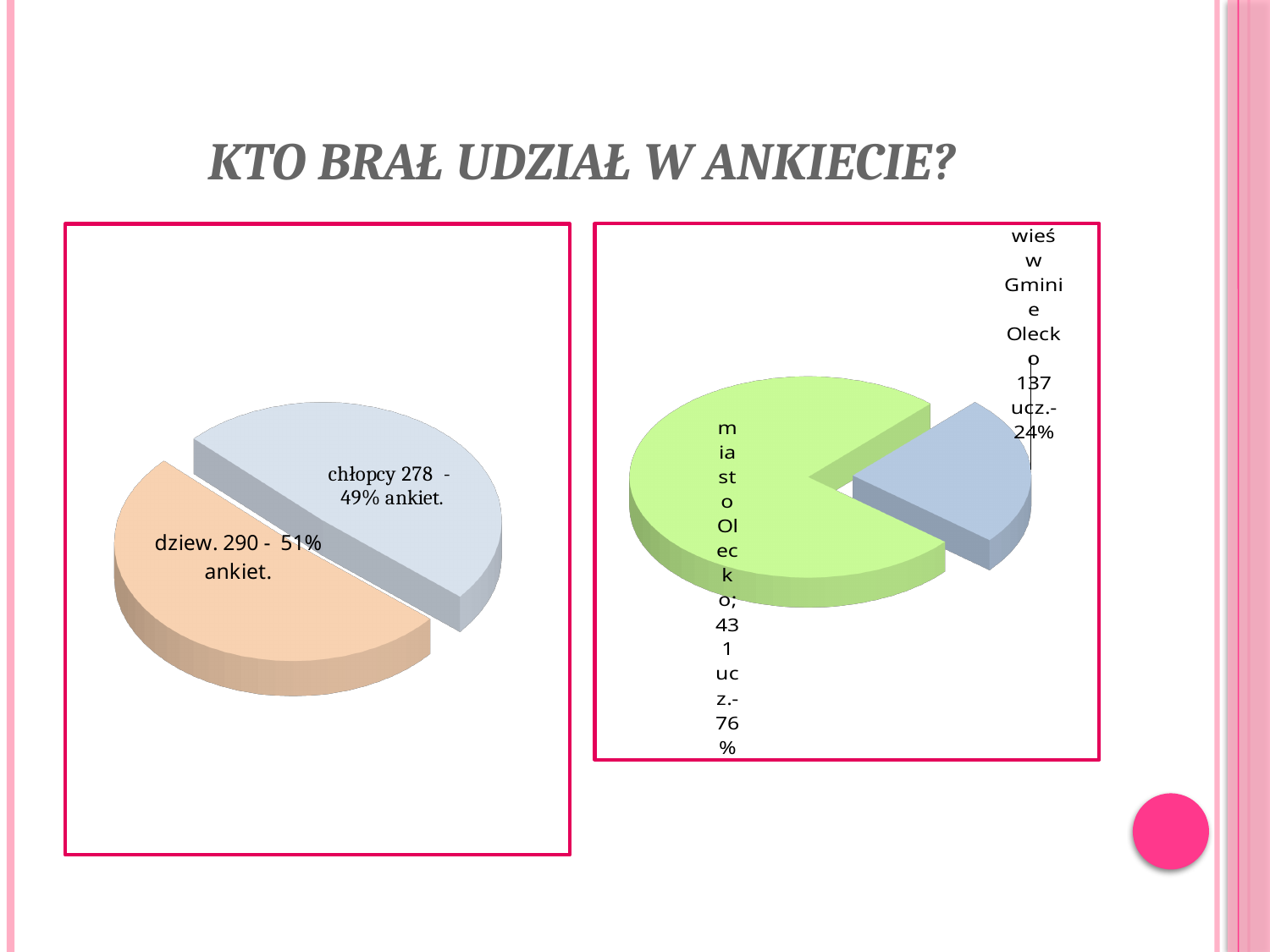
In the right pie chart, what is the total number of students across both slices (431 and 137)? 568 In the left pie chart, what percentage of surveys came from boys (chłopcy)? 49% What kind of chart is the left chart on the slide? pie chart In the right pie chart, how many students (ucz.) are from miasto Olecko? 431 What colour is the slice for miasto Olecko in the right pie chart? green What is the title of the slide above the two pie charts? KTO BRAŁ UDZIAŁ W ANKIECIE? In the left pie chart, what is the difference between the number of surveys from girls (290) and boys (278)? 12 In the left pie chart, how many surveys (ankiet) did girls (dziew.) complete? 290 In the left pie chart, which group has the larger slice, dziew. or chłopcy? dziew. In the right pie chart, which category has the smallest slice? wieś w Gminie Olecko In the right pie chart, what share of students come from wieś w Gminie Olecko? 24% How many slices does the left pie chart have? 2